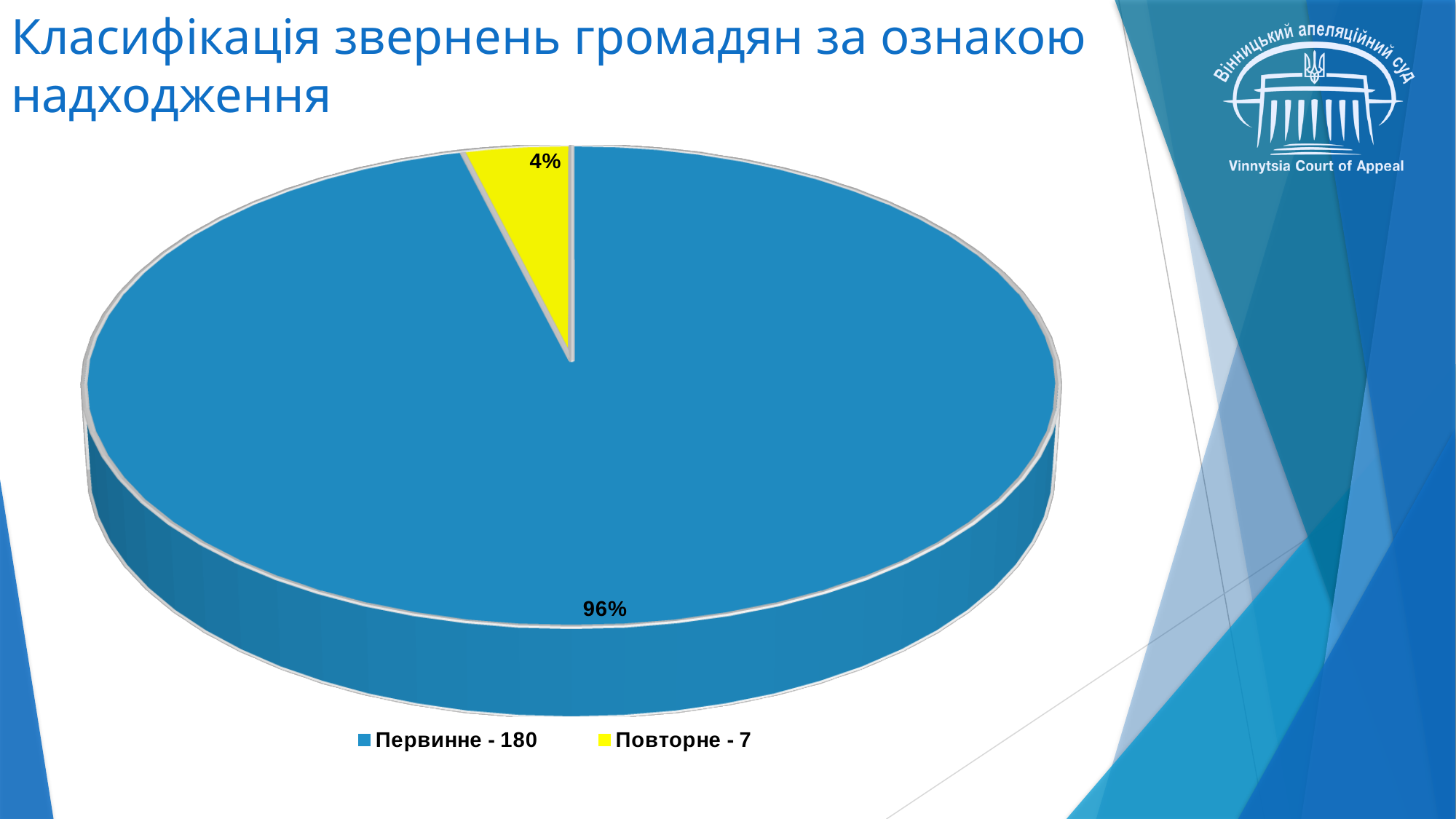
Which category has the smallest slice of the pie? Повторне - 7 What kind of chart is shown on the slide? pie chart What percentage share does the 'Повторне - 7' slice have? 4% Which category has the largest slice of the pie? Первинне - 180 What number is shown in the legend for the 'Первинне' category? 180 Which slice is larger, 'Первинне' or 'Повторне'? Первинне What is the difference in percentage points between the 'Первинне' and 'Повторне' slices? 92 What colour is the 'Повторне - 7' slice? yellow How many entries does the legend list? 2 What is the title of the slide containing the chart? Класифікація звернень громадян за ознакою надходження How many slices does the pie chart have? 2 What percentage share does the 'Первинне - 180' slice have? 96%